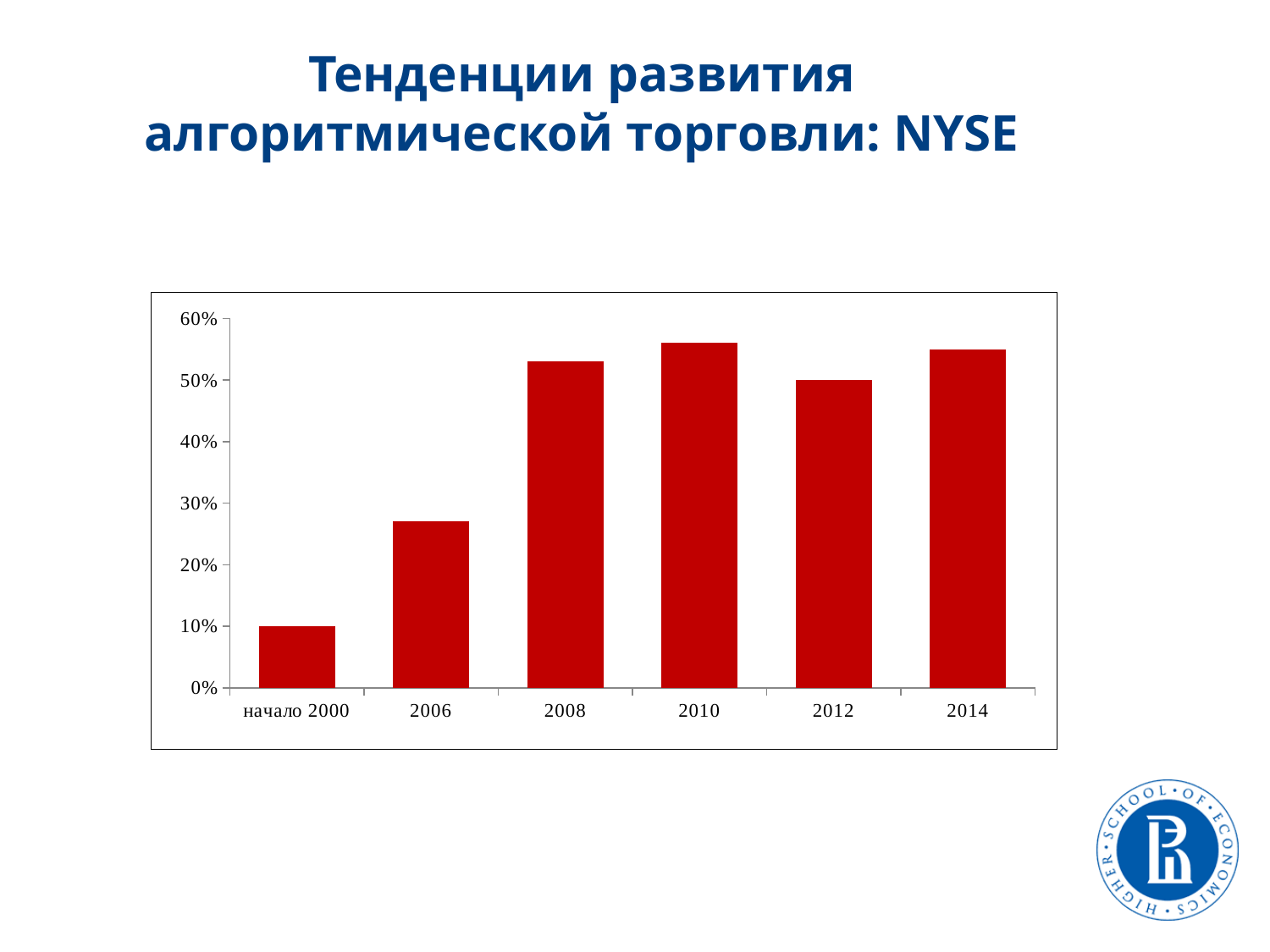
Which is larger, the value for 2010 or the value for 2012? 2010 Is the value for 2006 greater or less than 20%? greater Which is larger, the value for 2006 or the value for 2008? 2008 What is the value for начало 2000? 10% Which category has the lowest value in the chart? начало 2000 How many categories are shown on the x axis of the chart? 6 What kind of chart is shown on the slide? bar chart Is the value for 2008 greater or less than 50%? greater Is the value for 2006 greater or less than 30%? less What is the value for 2012? 50% What is the title of the slide containing the chart? Тенденции развития алгоритмической торговли: NYSE